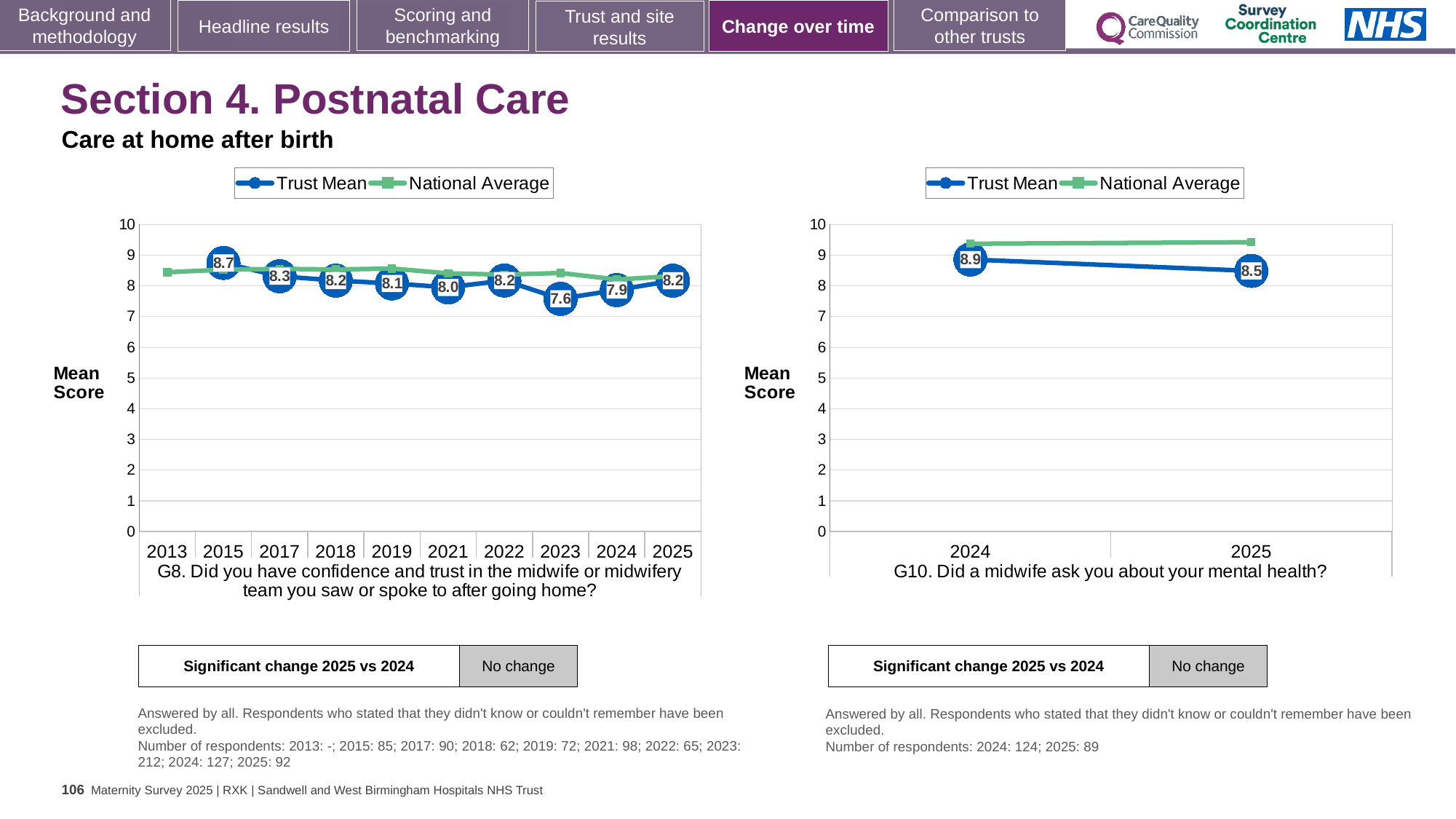
In the left chart (G8), how many years are shown on the x axis? 10 In the left chart (G8), which year has the highest Trust Mean? 2015 In the left chart (G8), what is the difference between the Trust Mean for 2025 and for 2024? 0.3 In the right chart (G10), how many series does the legend list? 2 In the left chart (G8), is the Trust Mean higher in 2015 or in 2025? 2015 In the left chart (G8), what is the Trust Mean for 2015? 8.7 In the left chart (G8), which year has the lowest Trust Mean? 2023 In the left chart (G8), what is the Trust Mean for 2023? 7.6 What kind of chart is the right chart (G10)? Line chart In the right chart (G10), what is the Trust Mean for 2024? 8.9 In the right chart (G10), what is the difference between the Trust Mean for 2024 and for 2025? 0.4 In the right chart (G10), is the National Average for 2025 greater or less than 9? greater